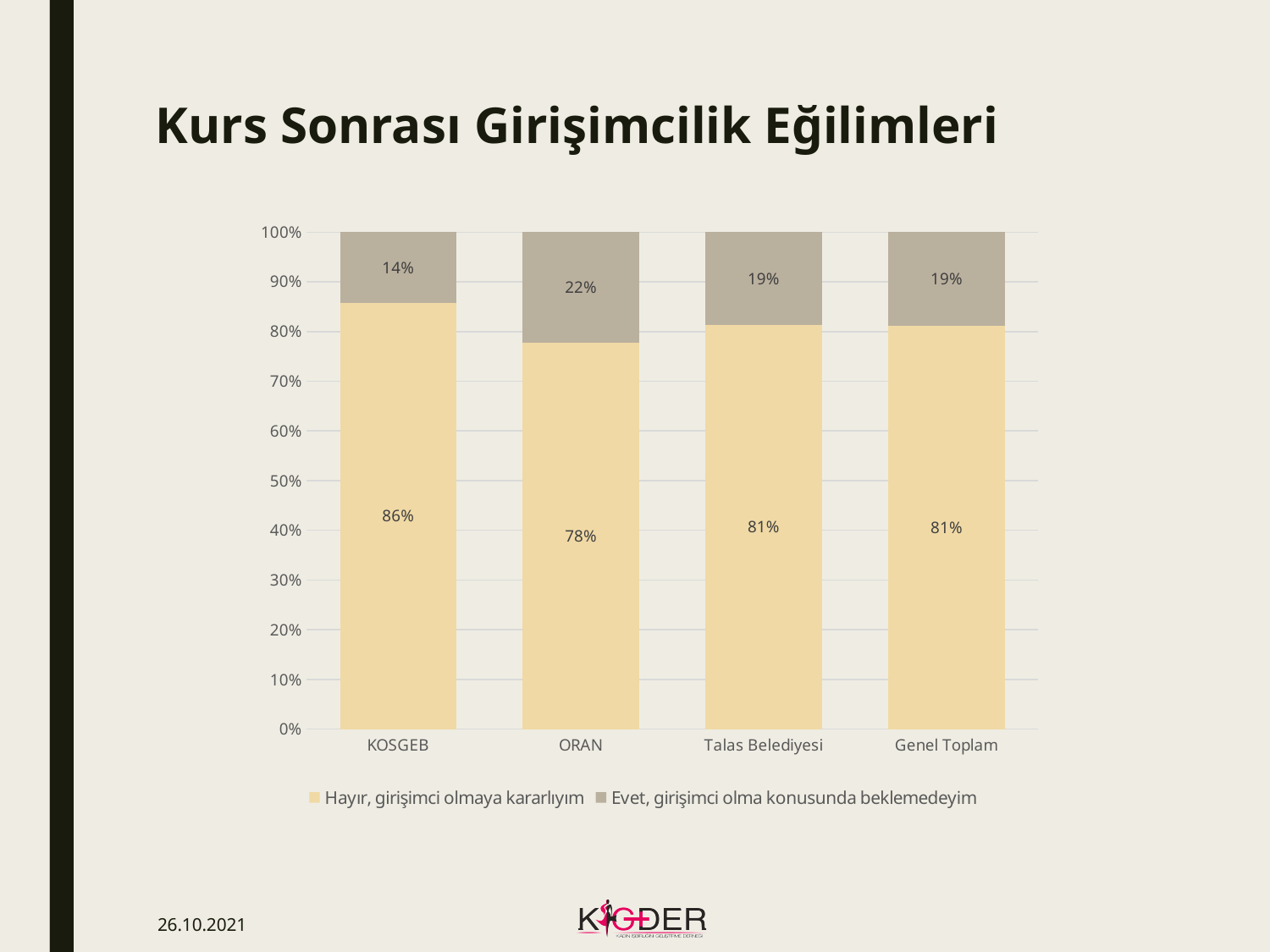
What is the value for 'Hayır, girişimci olmaya kararlıyım' for Talas Belediyesi? 81% How many series does the legend list? 2 What is the value for 'Evet, girişimci olma konusunda beklemedeyim' for Genel Toplam? 19% Which category has the highest value for 'Hayır, girişimci olmaya kararlıyım'? KOSGEB What is the difference between the 'Hayır, girişimci olmaya kararlıyım' values for KOSGEB and ORAN? 8% What is the value for 'Evet, girişimci olma konusunda beklemedeyim' for ORAN? 22% How many categories are shown on the x axis? 4 Which category has the highest value for 'Evet, girişimci olma konusunda beklemedeyim'? ORAN Is the 'Evet, girişimci olma konusunda beklemedeyim' value larger for KOSGEB or for Talas Belediyesi? Talas Belediyesi Which category has the lowest value for 'Hayır, girişimci olmaya kararlıyım'? ORAN What kind of chart is shown on the slide? Stacked bar chart What is the value for 'Hayır, girişimci olmaya kararlıyım' for KOSGEB? 86%